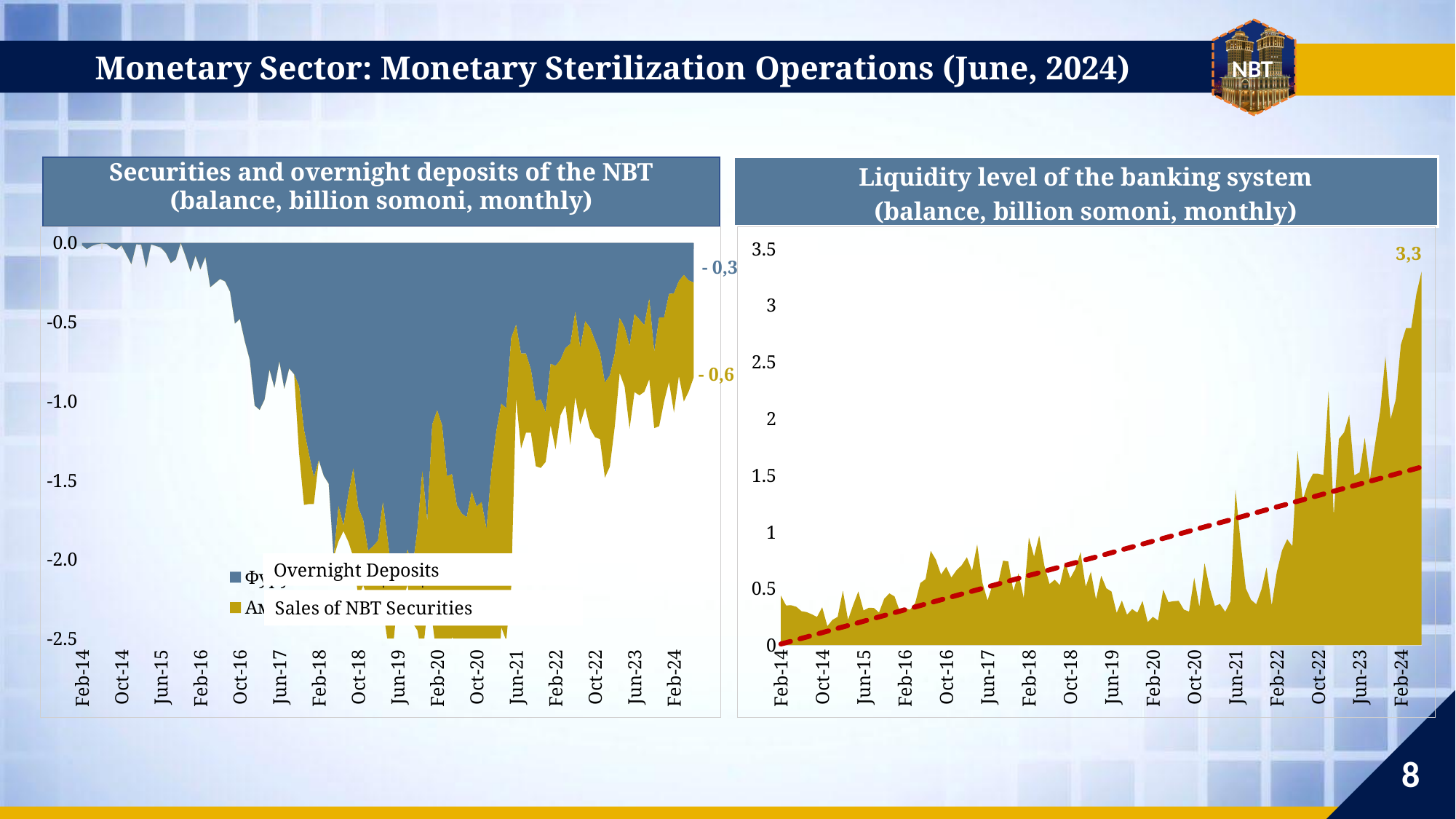
In the right chart, 'Liquidity level of the banking system', what is the highest value reached? 3,3 In the left chart, 'Securities and overnight deposits of the NBT', what is the difference between the latest labelled values of Overnight Deposits (-0,3) and Sales of NBT Securities (-0,6)? 0,3 How many series does the legend of the left chart, 'Securities and overnight deposits of the NBT', list? 2 In the right chart, 'Liquidity level of the banking system', what colour and style is the trend line? red dashed In the left chart, 'Securities and overnight deposits of the NBT', which series has the higher (less negative) latest labelled value? Overnight Deposits What kind of chart is the left chart, 'Securities and overnight deposits of the NBT'? area chart In the right chart, 'Liquidity level of the banking system', is the peak value greater or less than 3? greater In the left chart, 'Securities and overnight deposits of the NBT', what is the latest labelled value for Overnight Deposits? -0,3 In the left chart, 'Securities and overnight deposits of the NBT', what is the latest labelled value for Sales of NBT Securities? -0,6 What are the two legend entries in the left chart, 'Securities and overnight deposits of the NBT'? Overnight Deposits; Sales of NBT Securities In the right chart, 'Liquidity level of the banking system', what is the latest labelled value? 3,3 In the right chart, 'Liquidity level of the banking system', do values generally rise or fall from Feb-14 to Feb-24? rise